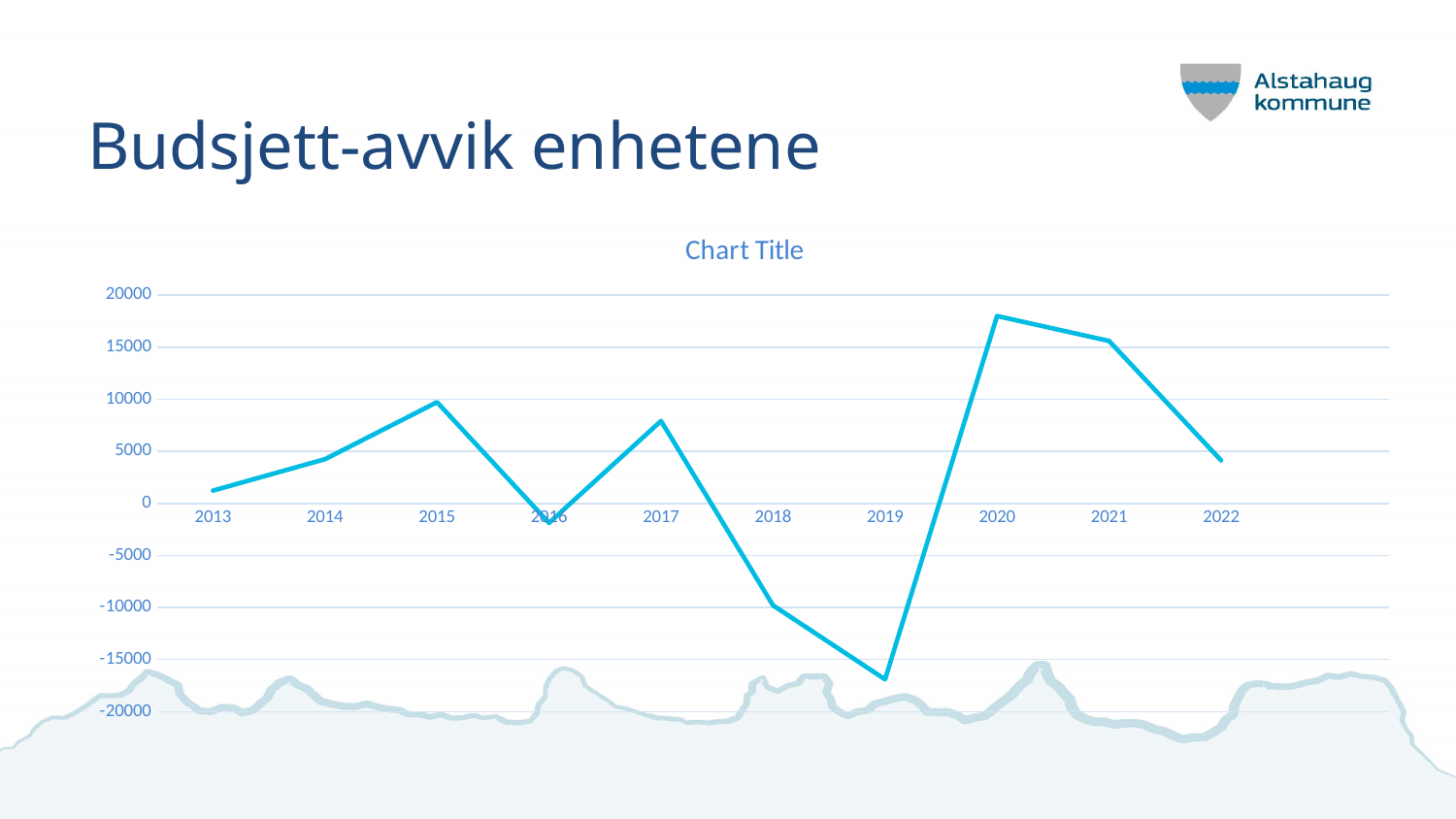
How many years are plotted along the x axis? 10 Is the value for 2018 greater or less than -5000? less Is the value for 2019 greater or less than -15000? less Do the values rise or fall from 2013 to 2015? rise Which year has the larger value, 2015 or 2017? 2015 Is the value for 2015 greater or less than 5000? greater What kind of chart is shown on the slide? line chart Do the values rise or fall from 2020 to 2022? fall What is the title shown above the chart? Chart Title Which year has the highest value? 2020 Which year has the lowest value? 2019